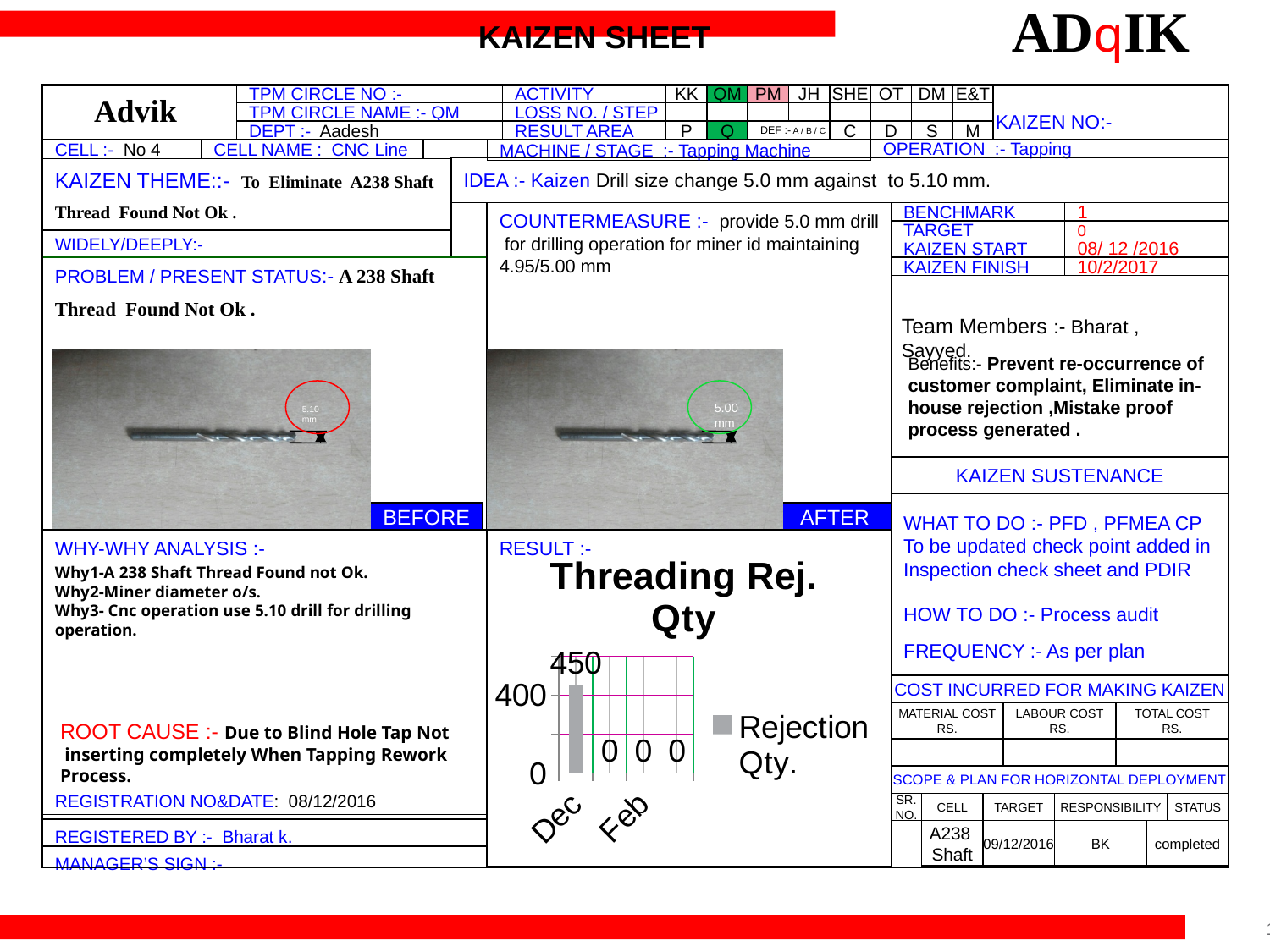
What is the title of the chart on the slide? Threading Rej. Qty Which is larger in the chart, the rejection quantity for Dec or for Feb? Dec How many bars are plotted in the chart? 4 What is the legend entry of the chart? Rejection Qty. What kind of chart is shown under RESULT on the slide? bar chart How many series does the chart's legend list? 1 Do the rejection quantities rise or fall from Dec to Feb in the chart? fall Which month has the highest rejection quantity in the chart? Dec Is the rejection quantity for Dec greater or less than 0? greater What is the rejection quantity for Feb in the chart? 0